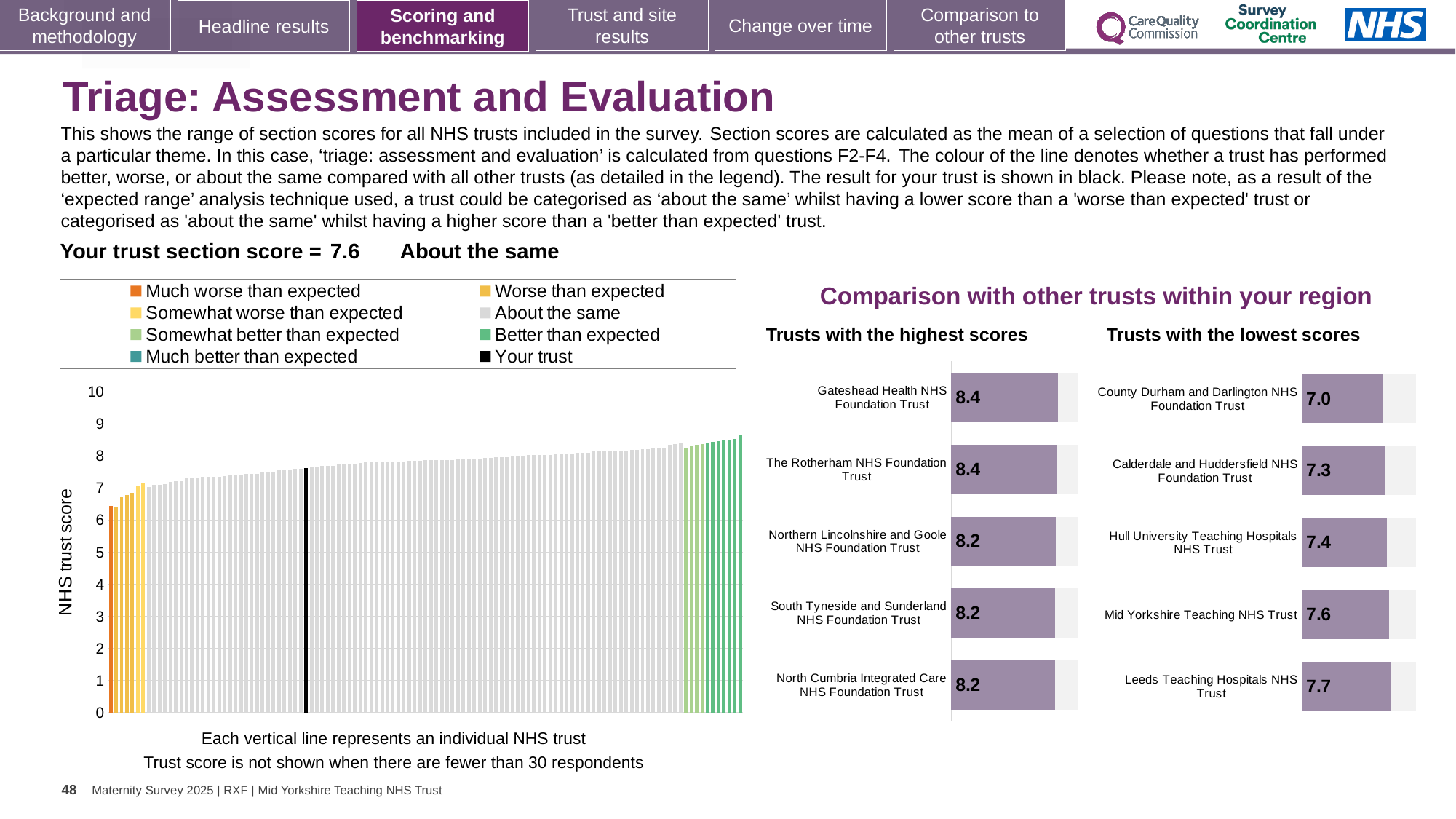
What kind of chart is the large chart on the left of the slide? bar chart How many entries does the legend of the large chart on the left list? 8 In the 'Trusts with the lowest scores' chart, what is the difference between the scores of Leeds Teaching Hospitals NHS Trust and County Durham and Darlington NHS Foundation Trust? 0.7 In the 'Trusts with the lowest scores' chart, which trust has the lowest score? County Durham and Darlington NHS Foundation Trust In the 'Trusts with the lowest scores' chart, which has the larger score: Hull University Teaching Hospitals NHS Trust or Calderdale and Huddersfield NHS Foundation Trust? Hull University Teaching Hospitals NHS Trust In the large chart on the left, is the value for the leftmost (orange) bar greater or less than 7? less How many trusts are shown in the 'Trusts with the highest scores' chart? 5 In the 'Trusts with the highest scores' chart, what is the score for North Cumbria Integrated Care NHS Foundation Trust? 8.2 In the 'Trusts with the highest scores' chart, what is the score for Gateshead Health NHS Foundation Trust? 8.4 In the 'Trusts with the lowest scores' chart, what is the score for County Durham and Darlington NHS Foundation Trust? 7.0 In the 'Trusts with the lowest scores' chart, which trust has the highest score? Leeds Teaching Hospitals NHS Trust In the large chart on the left, is the value for the black 'Your trust' bar greater or less than 7? greater